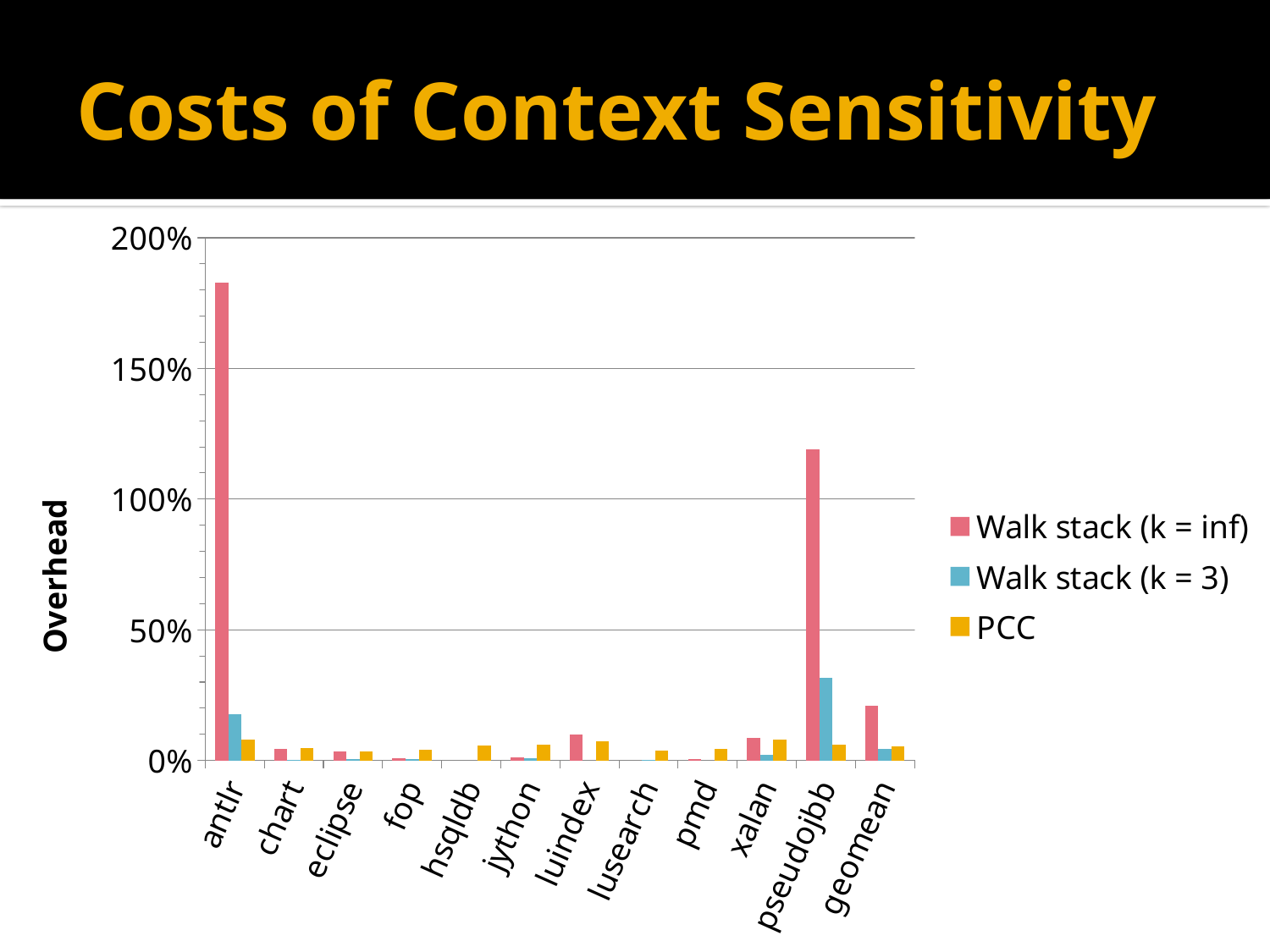
Which series is shown in yellow in the legend? PCC Which category has the highest Walk stack (k = inf) overhead? antlr How many series does the legend list? 3 Is the Walk stack (k = inf) value for antlr greater or less than 150%? greater For antlr, which series has the larger overhead: Walk stack (k = inf) or PCC? Walk stack (k = inf) Is the Walk stack (k = inf) value for geomean greater or less than 50%? less What kind of chart is shown on the slide? bar chart Is the Walk stack (k = inf) value for pseudojbb greater or less than 100%? greater For Walk stack (k = inf), which is larger: antlr or pseudojbb? antlr What is the label of the y axis? Overhead How many benchmark categories are shown on the x axis? 12